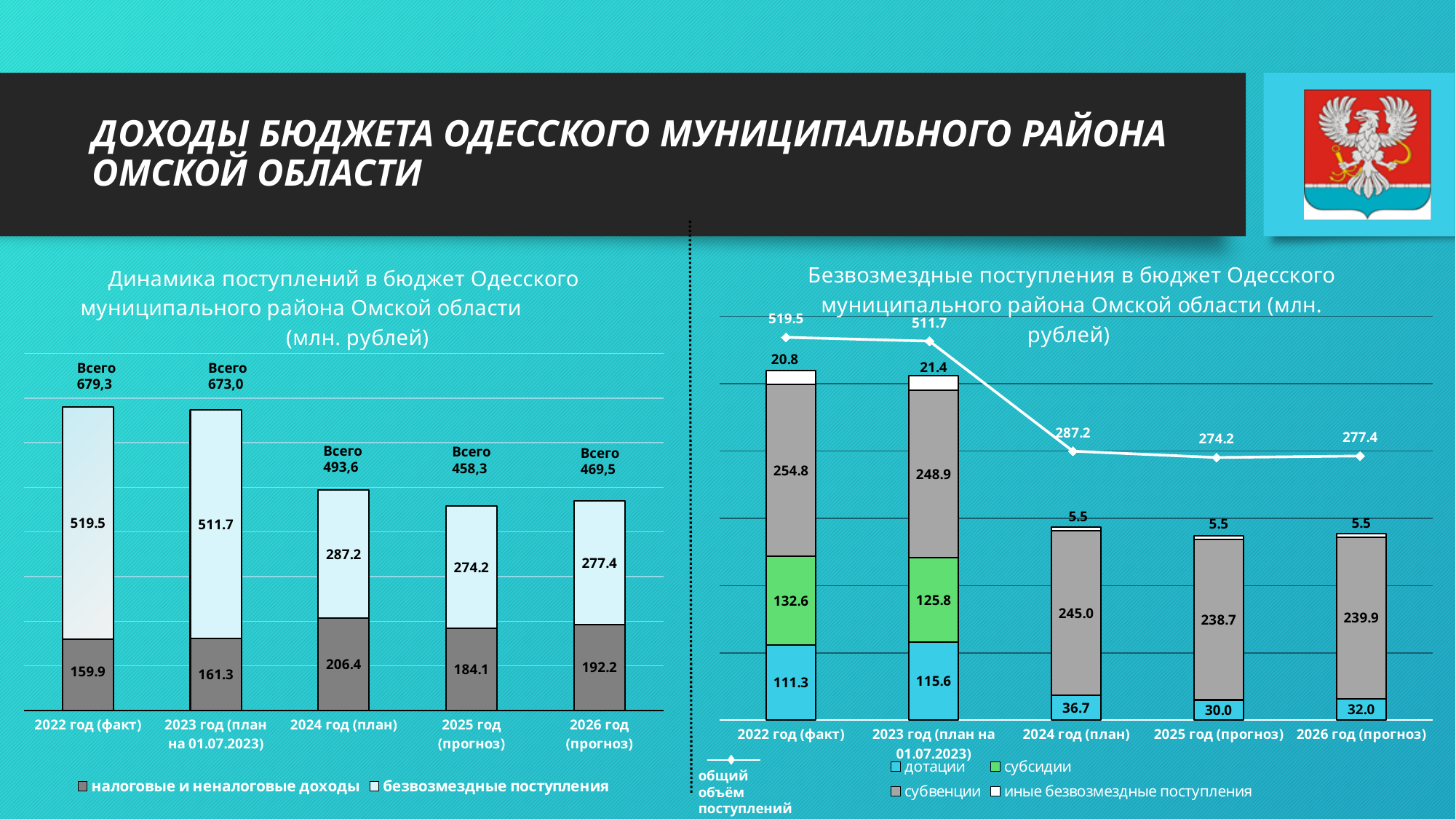
In the right chart (Безвозмездные поступления), what is the value of the общий объём поступлений line for 2024 год (план)? 287.2 In the left chart (Динамика поступлений в бюджет), what is the value of безвозмездные поступления for 2022 год (факт)? 519.5 In the right chart (Безвозмездные поступления), which year has the highest value of субвенции? 2022 год (факт) In the right chart (Безвозмездные поступления), is the value of субвенции larger in 2025 год (прогноз) or 2026 год (прогноз)? 2026 год (прогноз) In the left chart (Динамика поступлений в бюджет), what is the total (Всего) for 2025 год (прогноз)? 458,3 In the left chart (Динамика поступлений в бюджет), what is the value of налоговые и неналоговые доходы for 2024 год (план)? 206.4 In the right chart (Безвозмездные поступления), how many categories are shown on the x axis? 5 In the left chart (Динамика поступлений в бюджет), what is the difference between безвозмездные поступления in 2022 год (факт) and 2023 год (план на 01.07.2023)? 7.8 In the right chart (Безвозмездные поступления), what is the value of субсидии for 2023 год (план на 01.07.2023)? 125.8 In the left chart (Динамика поступлений в бюджет), how many series does the legend list? 2 In the left chart (Динамика поступлений в бюджет), which year has the lowest total (Всего)? 2025 год (прогноз) In the right chart (Безвозмездные поступления), what is the value of дотации for 2024 год (план)? 36.7